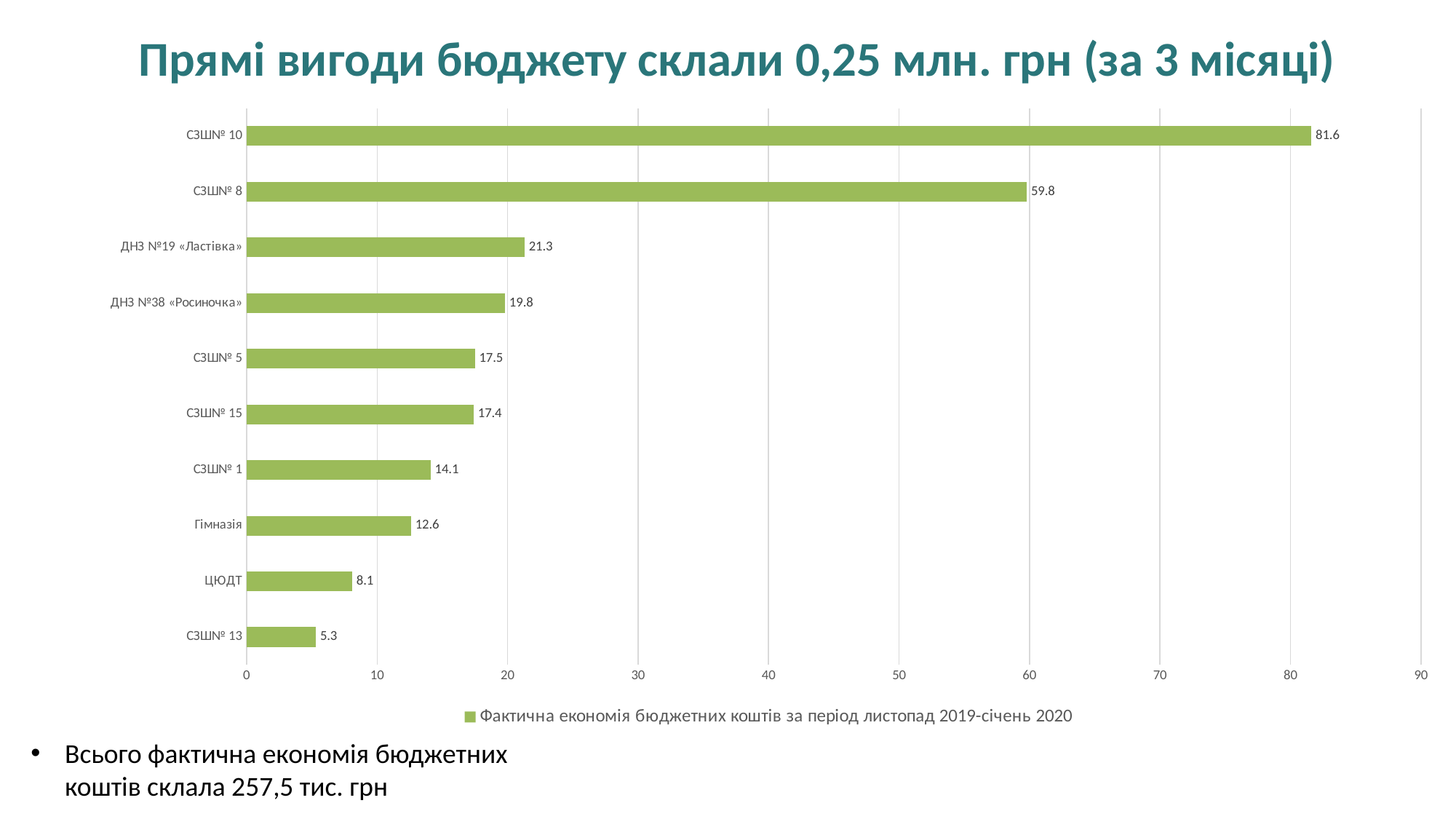
What is the value for ЦЮДТ? 8.1 Which is larger, the value for ДНЗ №19 «Ластівка» or the value for СЗШ№ 1? ДНЗ №19 «Ластівка» What kind of chart is shown on the slide? bar chart How many series does the legend list? 1 Which category has the lowest value? СЗШ№ 13 Is the value for СЗШ№ 8 greater or less than 50? greater What is the difference between the values for СЗШ№ 10 and СЗШ№ 8? 21.8 Which category has the highest value? СЗШ№ 10 How many categories are shown in the chart? 10 What is the value for ДНЗ №38 «Росиночка»? 19.8 What is the difference between the values for Гімназія and СЗШ№ 13? 7.3 What is the value for СЗШ№ 10? 81.6